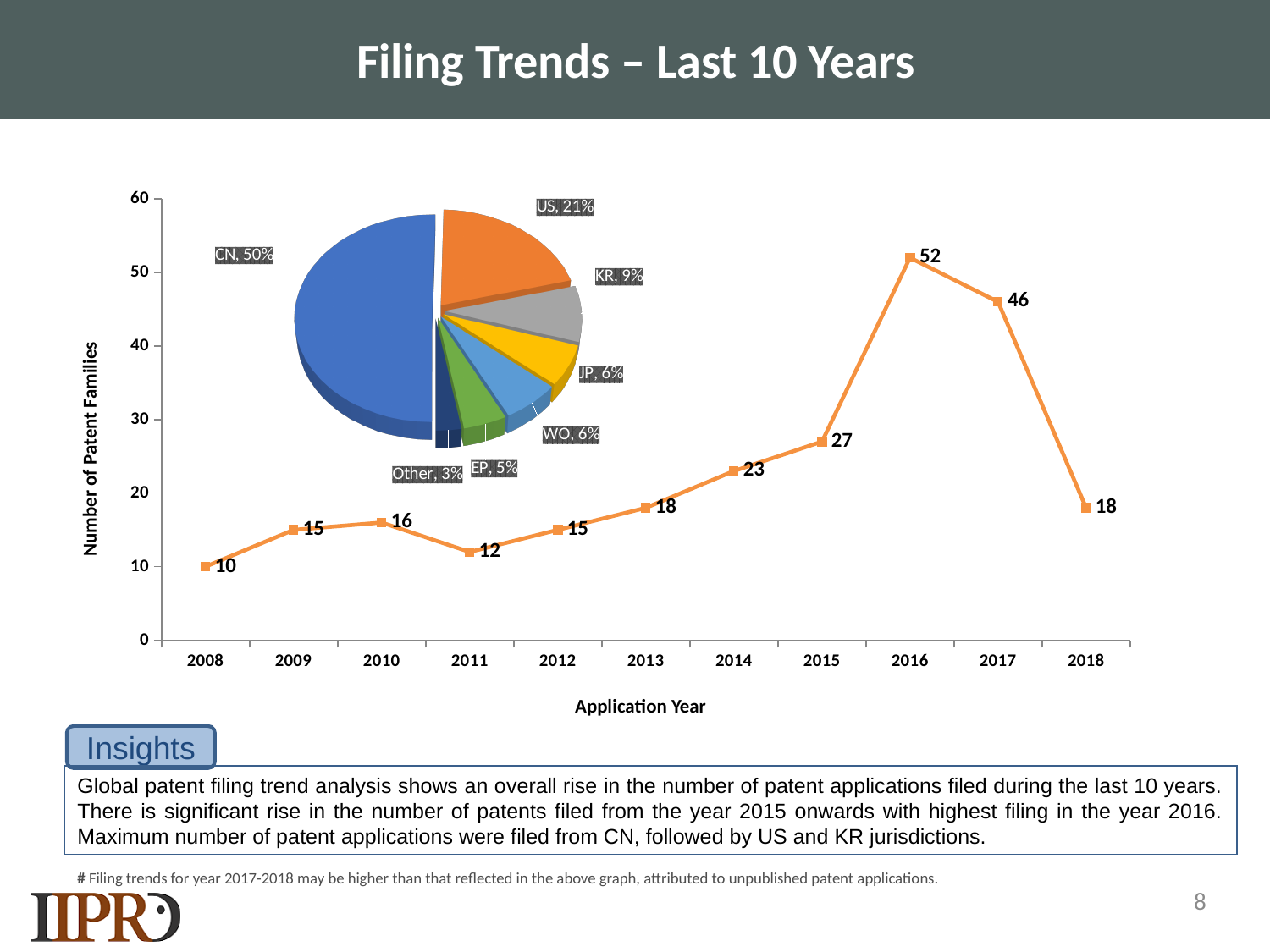
On the line chart, which year has more patent families, 2014 or 2018? 2014 On the pie chart, how many slices are there? 7 What is the x-axis title of the line chart? Application Year On the line chart, what is the number of patent families for application year 2016? 52 On the line chart, what is the number of patent families for application year 2011? 12 On the line chart, which application year has the lowest number of patent families? 2008 On the pie chart, what share does CN hold? 50% On the line chart, which application year has the highest number of patent families? 2016 On the line chart, what is the difference in number of patent families between 2016 and 2017? 6 On the line chart, how many application years are plotted? 11 On the line chart, do the values rise or fall from 2012 to 2016? rise On the pie chart, which jurisdiction has the smallest share? Other